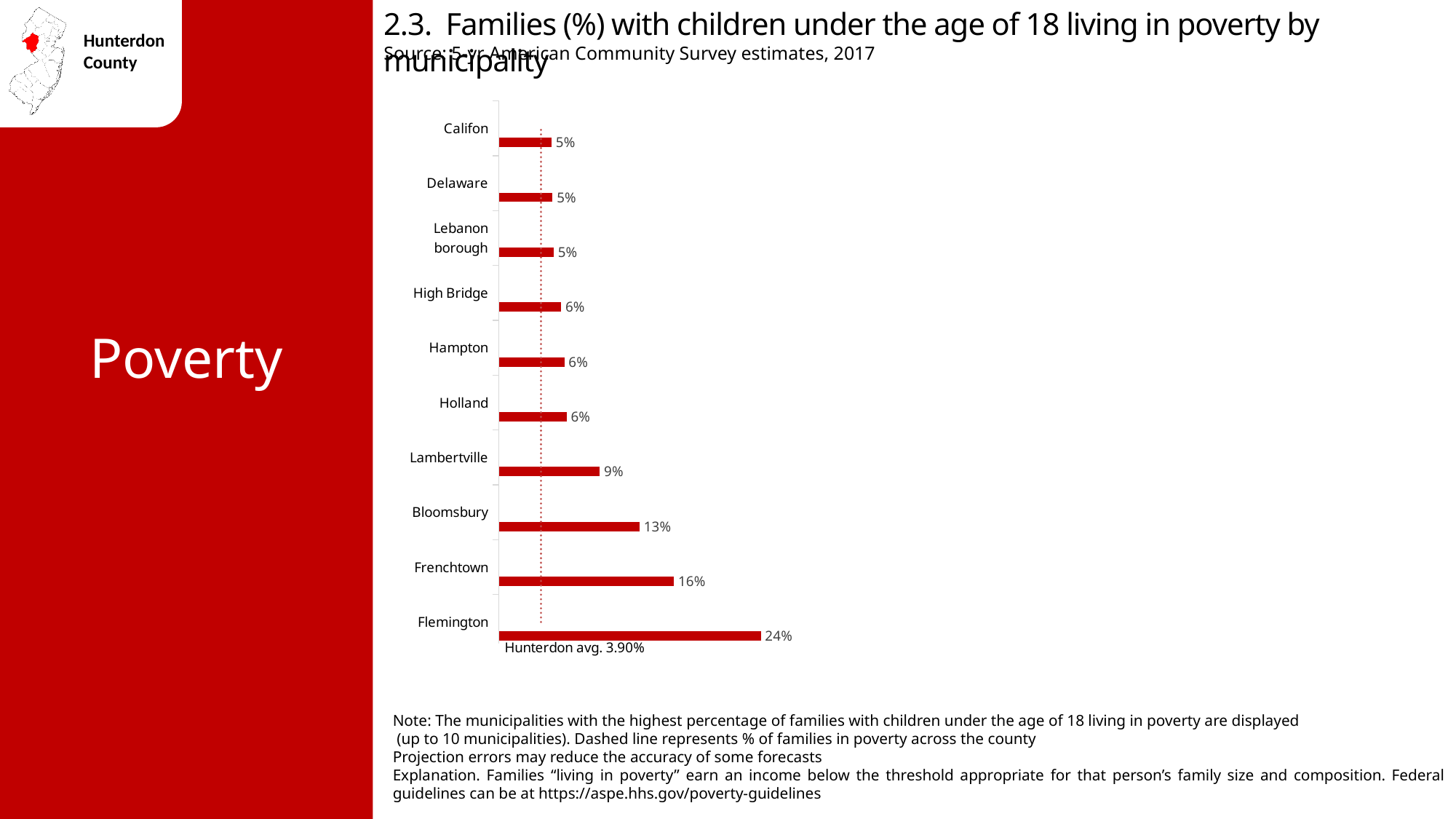
Which has a higher value, Lambertville or Holland? Lambertville What percentage of families with children under 18 are living in poverty in Flemington? 24% What is the difference between the values for Flemington and Frenchtown? 8% What is the value shown for Frenchtown? 16% What kind of chart is shown on the slide? Bar chart Which has a higher value, Frenchtown or Bloomsbury? Frenchtown What Hunterdon County average value is marked by the dotted line on the chart? 3.90% Which municipality has the highest percentage of families with children under 18 living in poverty? Flemington What is the difference between the values for Bloomsbury and Lambertville? 4% What is the value shown for Lambertville? 9% How many municipalities are shown in the chart? 10 What is the value shown for Bloomsbury? 13%